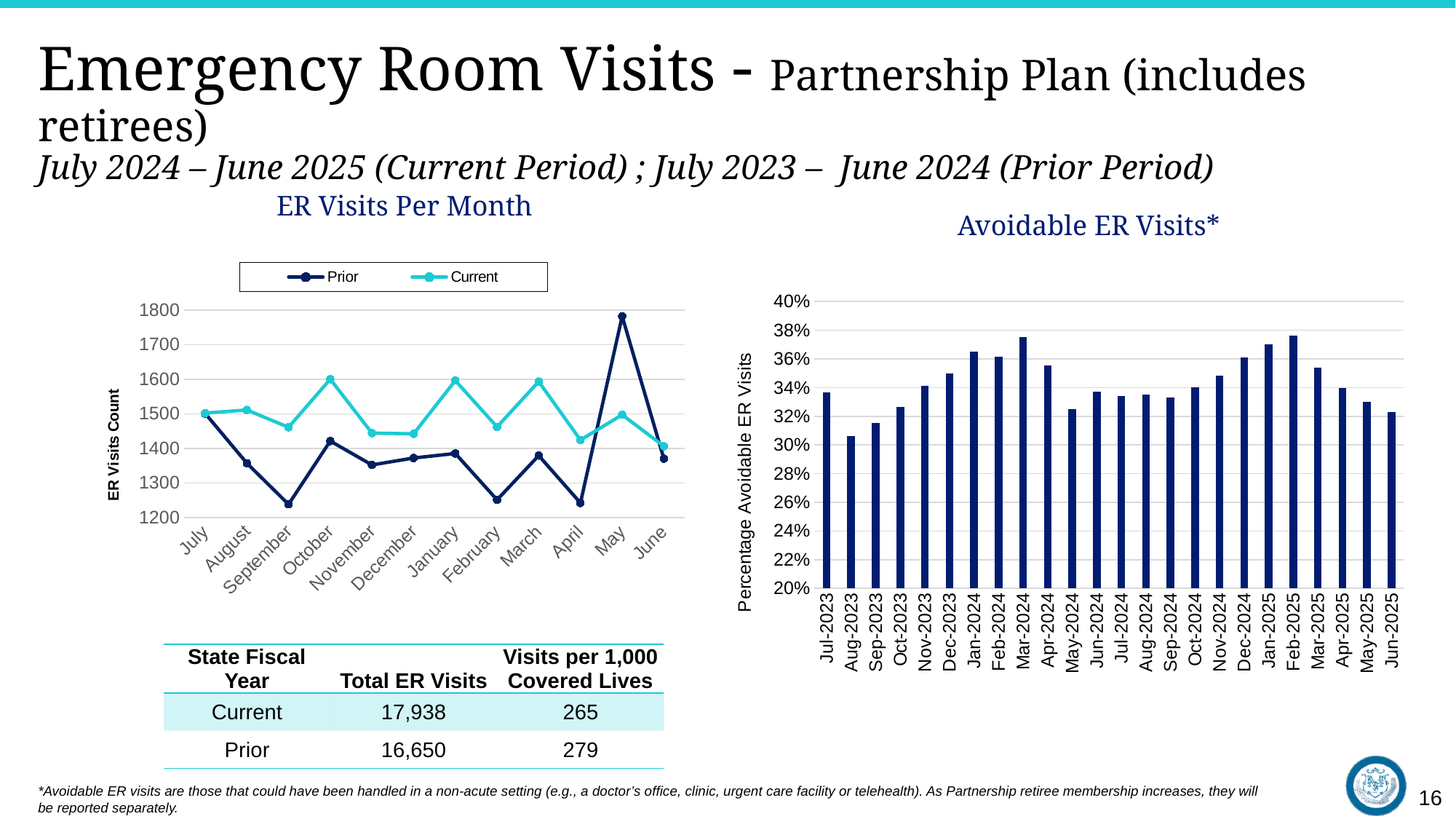
In the "ER Visits Per Month" chart, is the Prior value for May greater or less than 1700? greater In the "ER Visits Per Month" chart, which series has the higher value in May, Prior or Current? Prior How many series does the legend of the "ER Visits Per Month" chart list? 2 What kind of chart is the "ER Visits Per Month" chart? line chart In the "ER Visits Per Month" chart, in which month is the Prior series highest? May How many months are plotted on the x axis of the "ER Visits Per Month" chart? 12 In the "Avoidable ER Visits*" chart, which month has the lowest percentage? Aug-2023 In the "ER Visits Per Month" chart, which series has the higher value in September, Prior or Current? Current How many bars are shown in the "Avoidable ER Visits*" chart? 24 In the "Avoidable ER Visits*" chart, is the value for Mar-2024 greater or less than 36%? greater In the "ER Visits Per Month" chart, is the Prior value for September greater or less than 1300? less What kind of chart is the "Avoidable ER Visits*" chart? bar chart